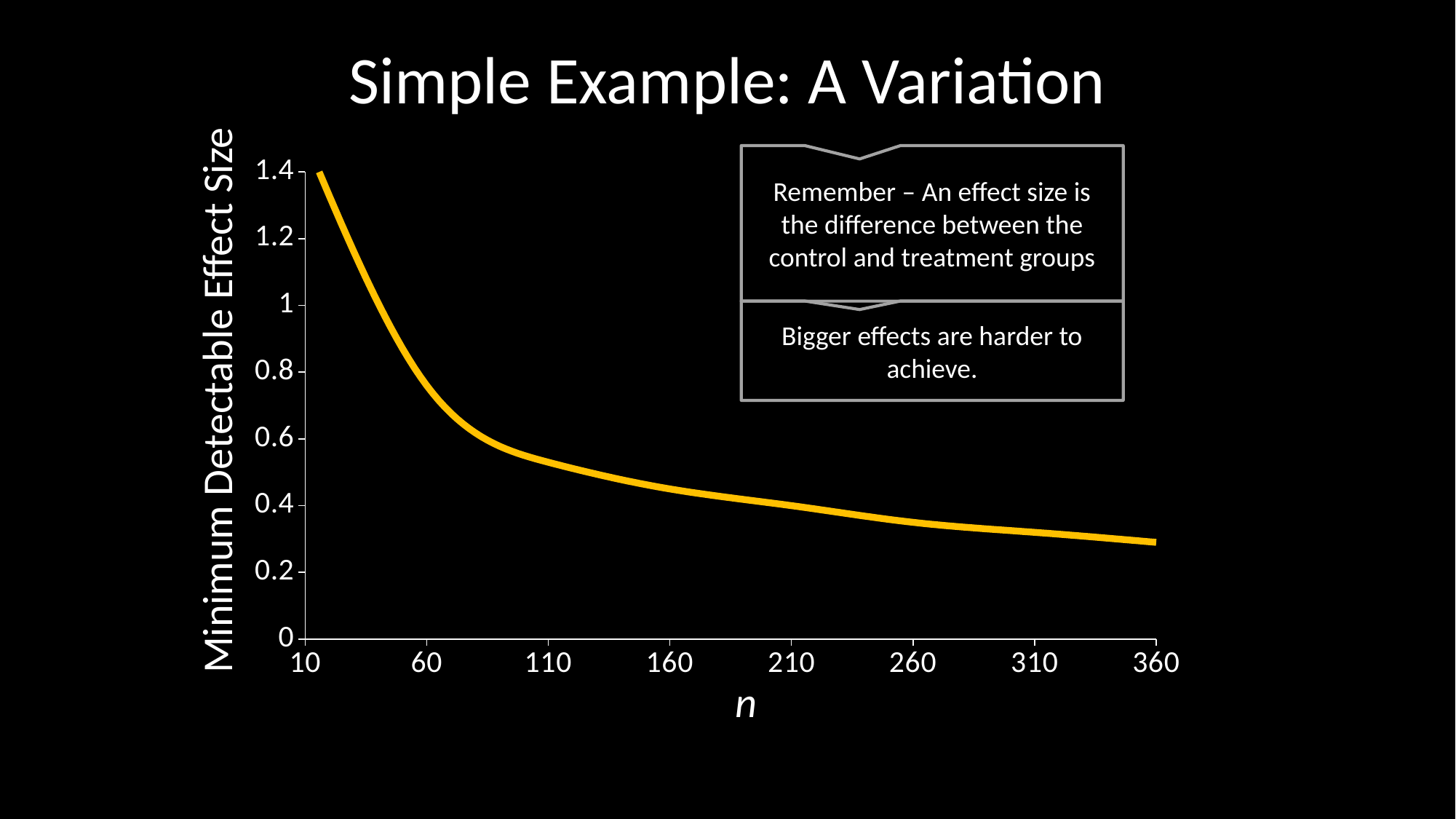
Is the minimum detectable effect size at n = 110 greater or less than 0.6? less Is the minimum detectable effect size at n = 160 greater or less than 0.6? less What is the label of the x axis? n Does the minimum detectable effect size rise or fall as n increases along the x axis? fall Is the minimum detectable effect size at the left end of the curve (n = 10) greater or less than 1.2? greater What kind of chart is shown on the slide? line chart At which value of n shown on the x axis is the minimum detectable effect size lowest? 360 At which value of n shown on the x axis is the minimum detectable effect size highest? 10 What is the label of the y axis? Minimum Detectable Effect Size